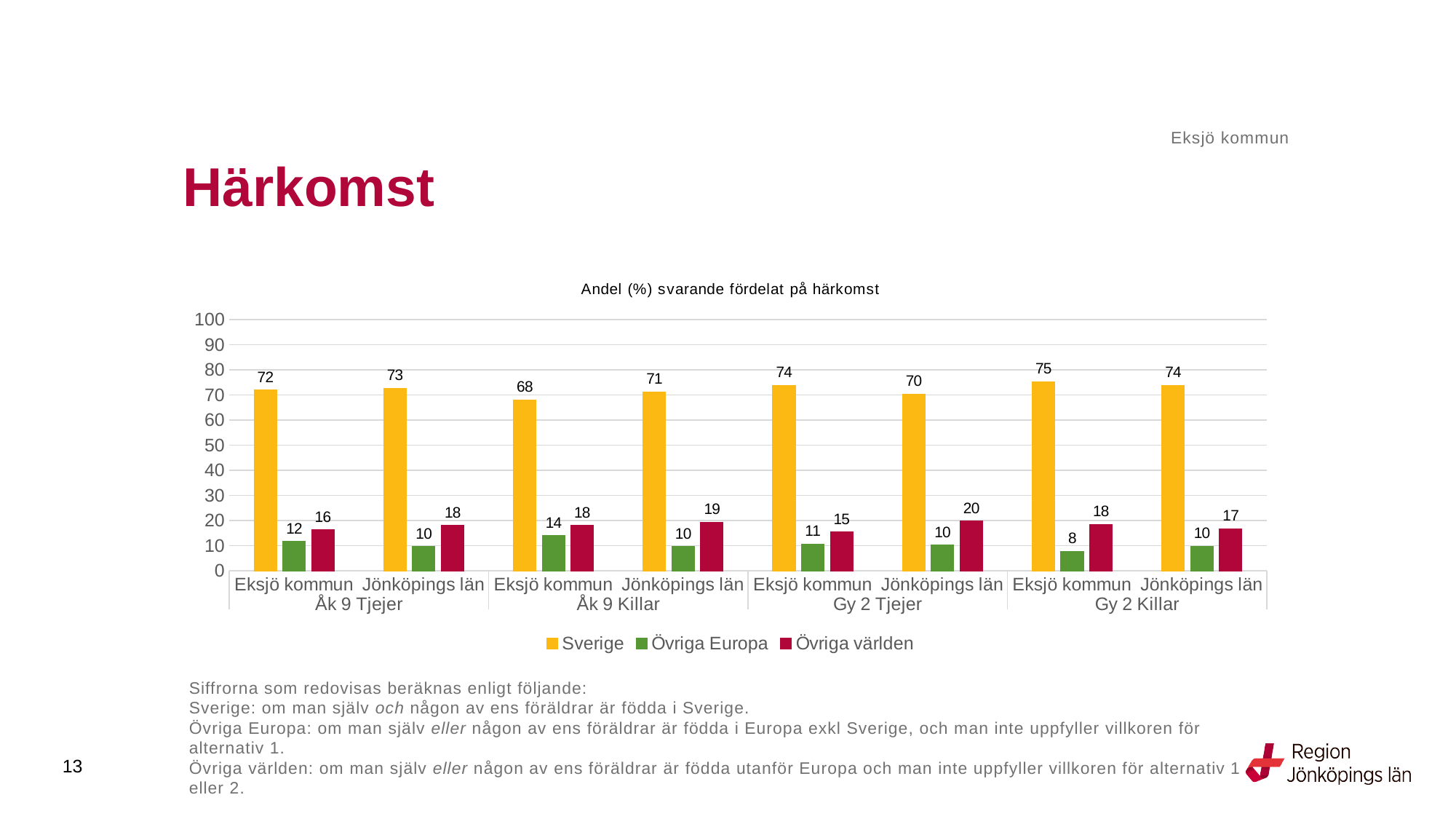
What is the difference between the Sverige values for Eksjö kommun and Jönköpings län in the Gy 2 Tjejer group? 4 What is the value for Övriga Europa for Eksjö kommun in the Gy 2 Killar group? 8 In the Åk 9 Killar group, which has the larger Övriga Europa value: Eksjö kommun or Jönköpings län? Eksjö kommun What kind of chart is shown on the slide? bar chart What is the value for Övriga världen for Jönköpings län in the Gy 2 Tjejer group? 20 What is the value for Sverige for Eksjö kommun in the Åk 9 Tjejer group? 72 Is the Sverige value for Jönköpings län in the Åk 9 Killar group greater or less than 80? less Which category has the lowest Sverige value? Eksjö kommun, Åk 9 Killar What is the title of the chart? Andel (%) svarande fördelat på härkomst How many category groups (bar clusters) are shown along the x axis? 8 How many series does the legend list? 3 Which category has the highest Sverige value? Eksjö kommun, Gy 2 Killar